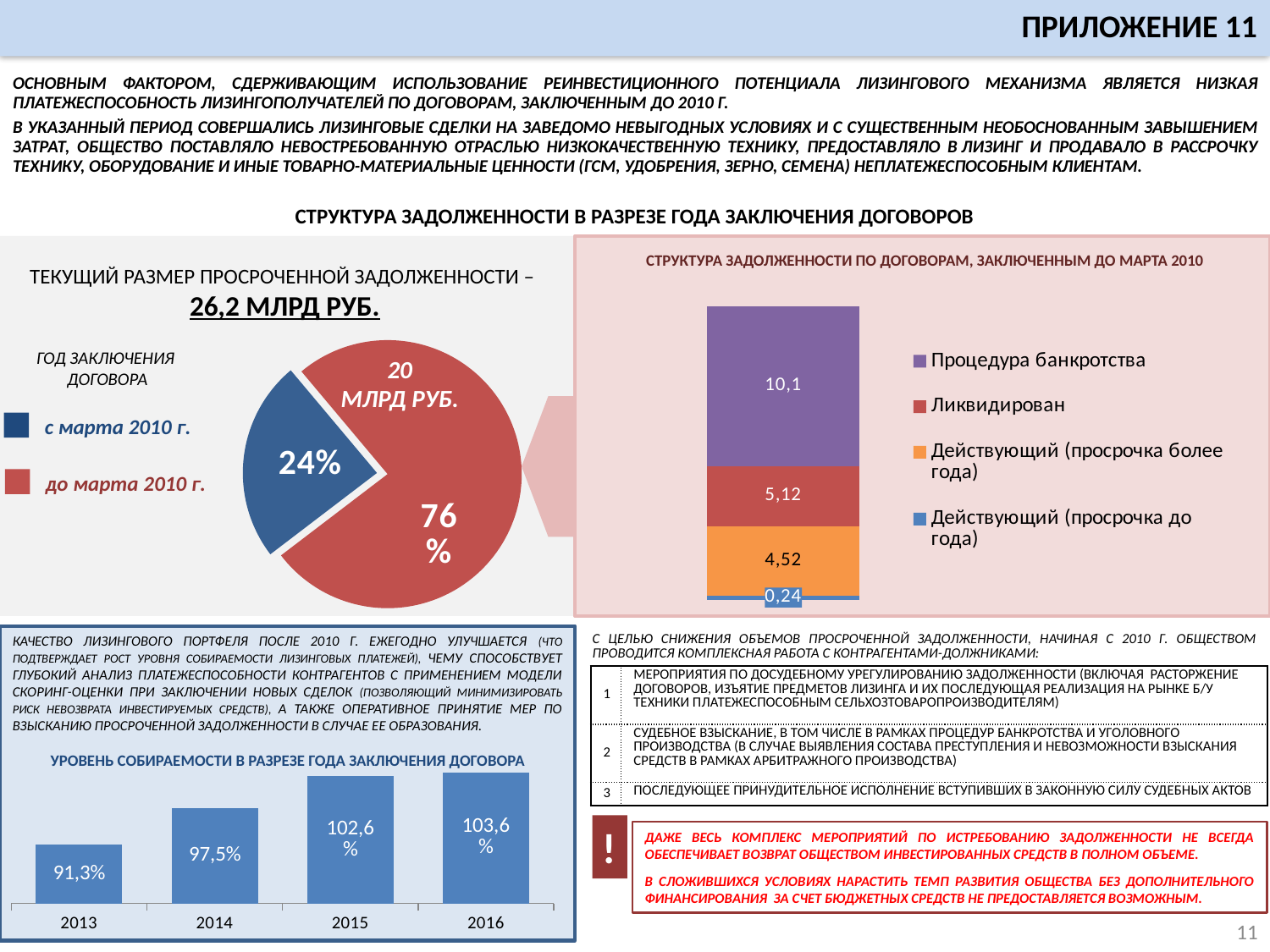
In the chart 'Уровень собираемости в разрезе года заключения договора', which year has the highest value? 2016 In the stacked bar chart 'Структура задолженности по договорам, заключенным до марта 2010', which segment is the smallest? Действующий (просрочка до года) In the chart 'Уровень собираемости в разрезе года заключения договора', do the values rise or fall from 2013 to 2016? rise In the chart 'Уровень собираемости в разрезе года заключения договора', what is the value for 2014? 97,5% In the stacked bar chart 'Структура задолженности по договорам, заключенным до марта 2010', how many series does the legend list? 4 In the pie chart on the left, which slice is larger: 'с марта 2010 г.' or 'до марта 2010 г.'? до марта 2010 г. In the stacked bar chart 'Структура задолженности по договорам, заключенным до марта 2010', what is the difference between 'Процедура банкротства' and 'Ликвидирован'? 4,98 In the pie chart on the left, what share of overdue debt relates to contracts concluded from March 2010 (с марта 2010 г.)? 24% In the pie chart on the left, what share of overdue debt relates to contracts concluded before March 2010 (до марта 2010 г.)? 76% In the stacked bar chart 'Структура задолженности по договорам, заключенным до марта 2010', what is the value for 'Процедура банкротства'? 10,1 In the stacked bar chart 'Структура задолженности по договорам, заключенным до марта 2010', what is the value for 'Ликвидирован'? 5,12 In the pie chart on the left, how many slices are there? 2